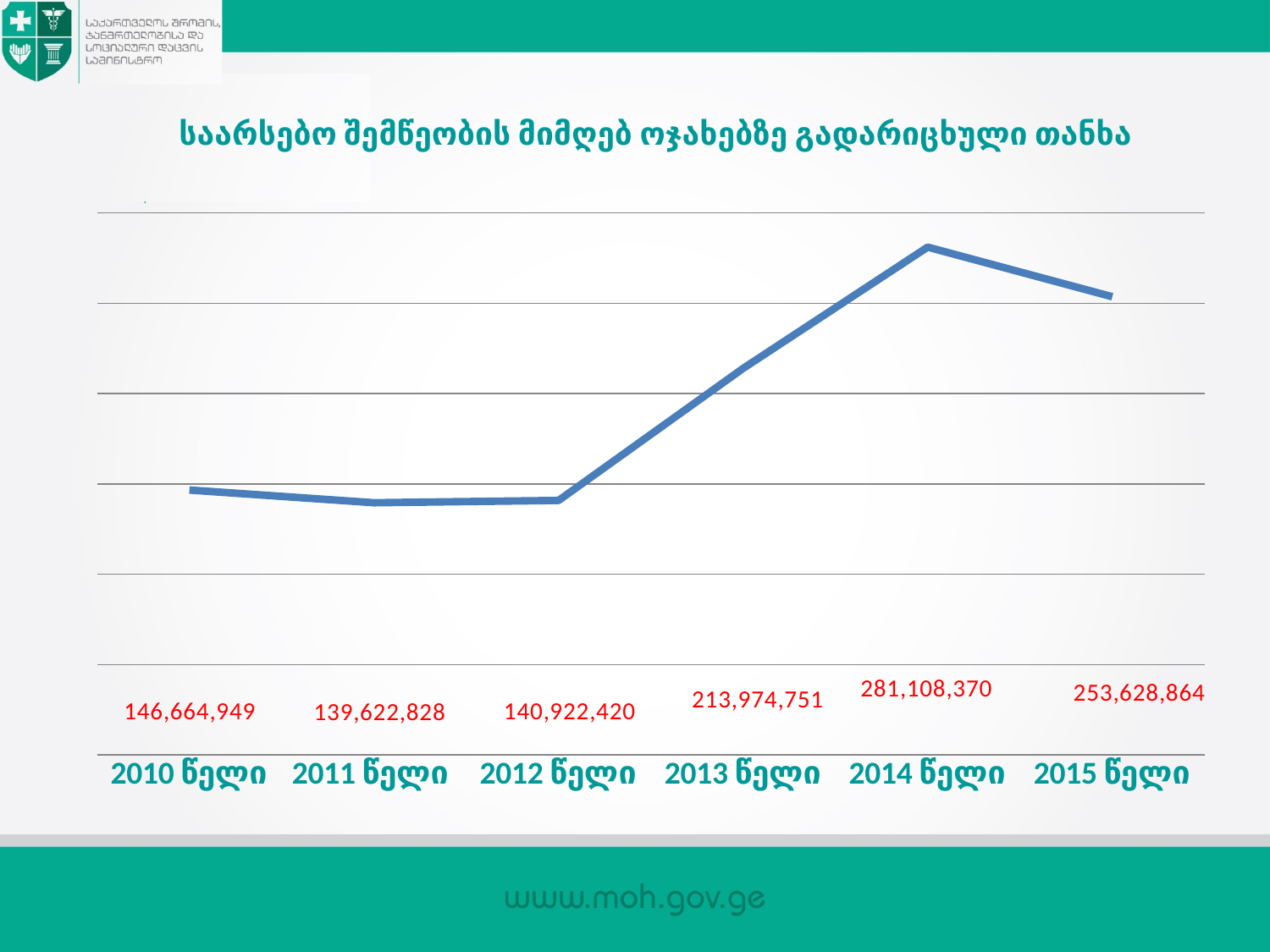
What is the value for 2013 წელი? 213,974,751 What is the difference between the values for 2014 წელი and 2015 წელი? 27,479,506 What is the value for 2015 წელი? 253,628,864 Which year has the lowest value? 2011 წელი What type of chart is shown on the slide? line chart What is the difference between the values for 2013 წელი and 2012 წელი? 73,052,331 Which is larger, the value for 2010 წელი or the value for 2012 წელი? 2010 წელი Which year has the highest value? 2014 წელი How many years are plotted on the chart? 6 Does the value rise or fall from 2012 წელი to 2014 წელი? rise What is the value for 2010 წელი? 146,664,949 What colour is the line in the chart? blue